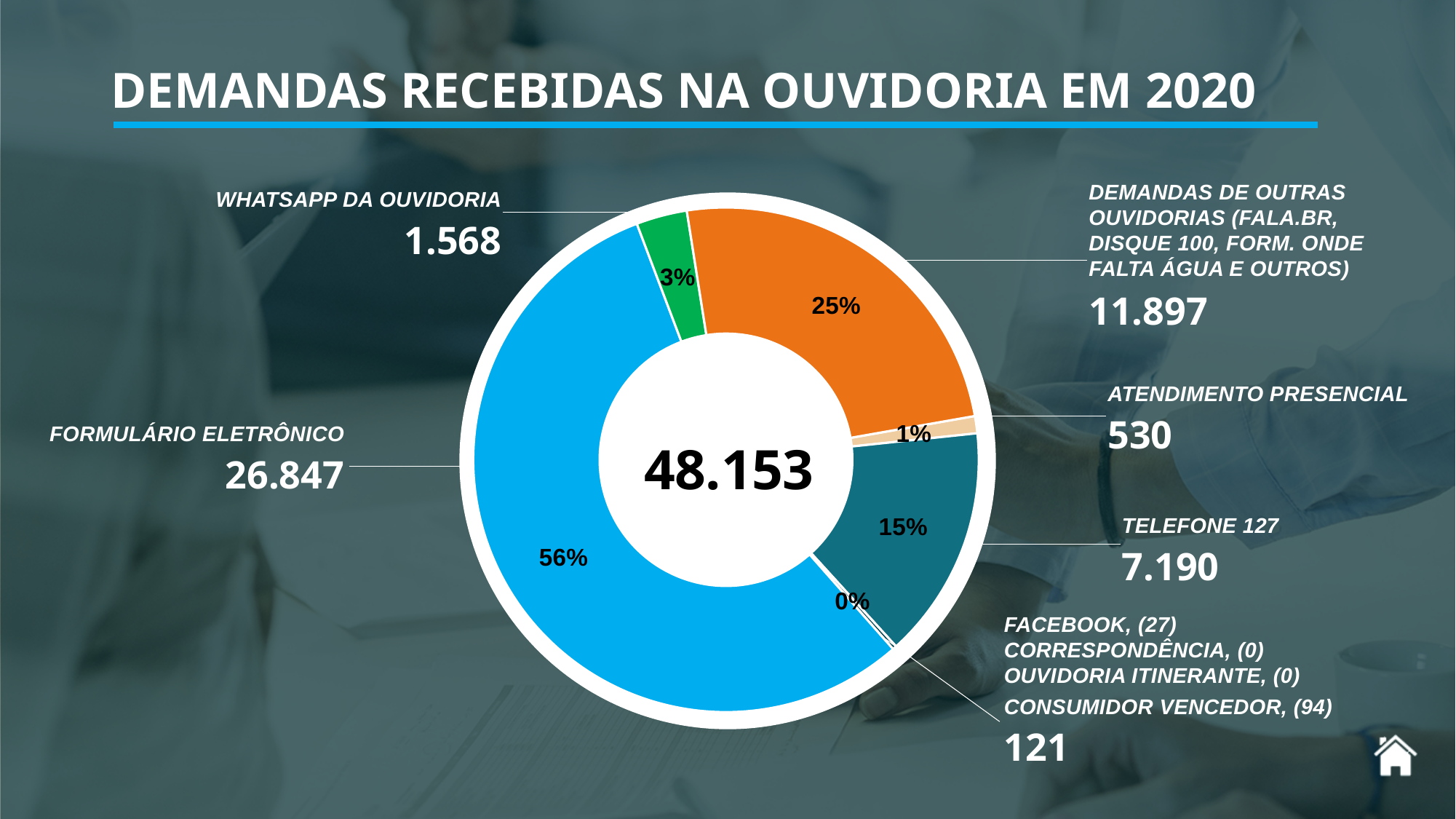
What is the difference between the values for FORMULÁRIO ELETRÔNICO and TELEFONE 127? 19.657 Which is larger, the value for WHATSAPP DA OUVIDORIA or the value for ATENDIMENTO PRESENCIAL? WHATSAPP DA OUVIDORIA Which category has the largest slice in the chart? FORMULÁRIO ELETRÔNICO What total is shown in the centre of the donut chart? 48.153 What is the value shown for WHATSAPP DA OUVIDORIA? 1.568 Which category has the smallest slice in the chart? FACEBOOK, CORRESPONDÊNCIA, OUVIDORIA ITINERANTE, CONSUMIDOR VENCEDOR (121) What is the value shown for TELEFONE 127? 7.190 What kind of chart is shown on the slide? Pie (donut) chart What percentage share of the chart does DEMANDAS DE OUTRAS OUVIDORIAS represent? 25% What percentage share of the chart does FORMULÁRIO ELETRÔNICO represent? 56% What is the value shown for FORMULÁRIO ELETRÔNICO? 26.847 What is the value shown for ATENDIMENTO PRESENCIAL? 530